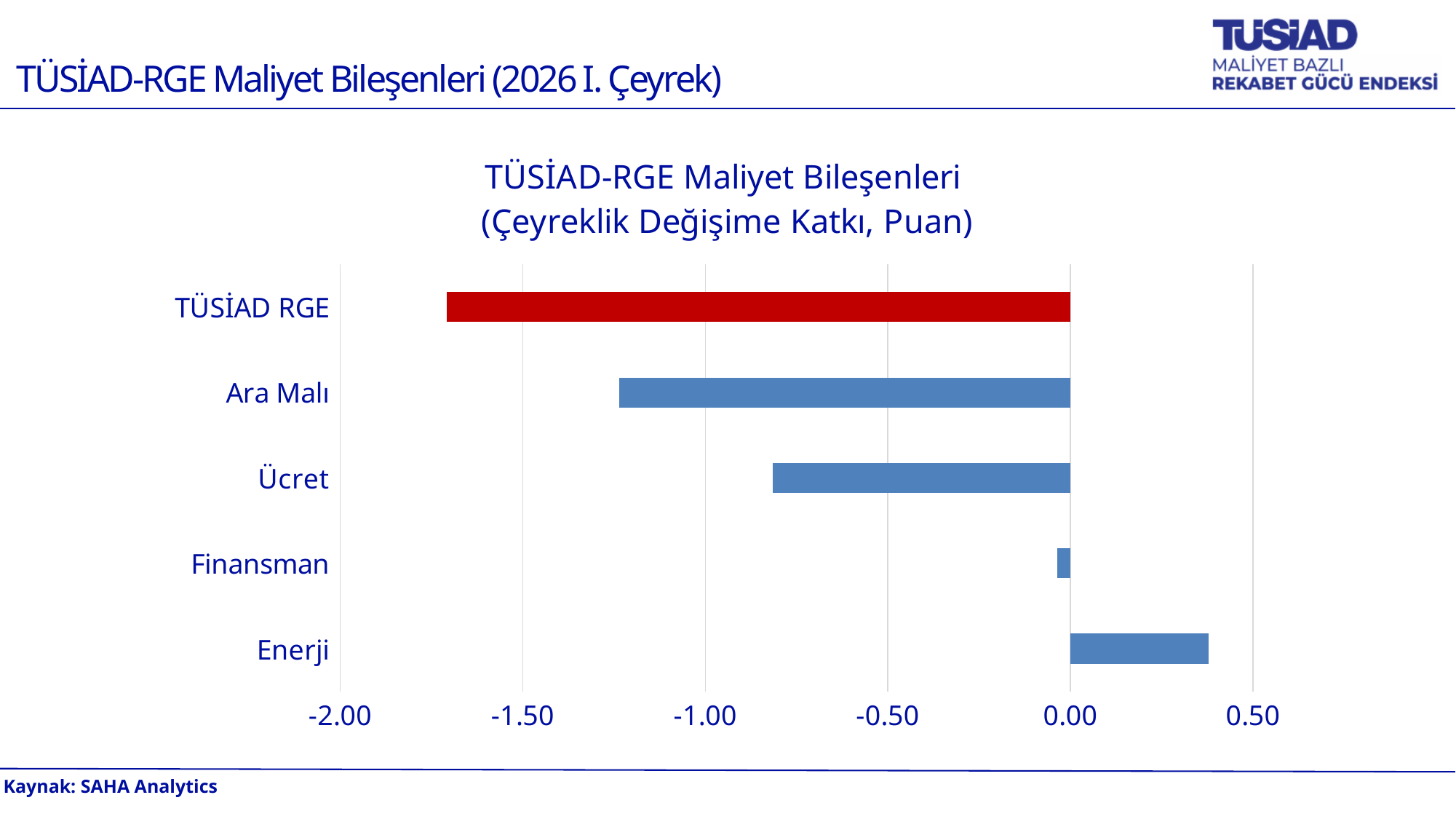
What colour is the bar for TÜSİAD RGE? red Is the value for Ara Malı greater or less than -1.00? less Is the value for Finansman greater or less than -0.50? greater What kind of chart is shown on the slide? bar chart Is the value for TÜSİAD RGE greater or less than -1.50? less Which has the larger value, Ara Malı or Ücret? Ücret How many categories are plotted in the chart? 5 Which category has the lowest (most negative) value? TÜSİAD RGE Which category has the highest value? Enerji